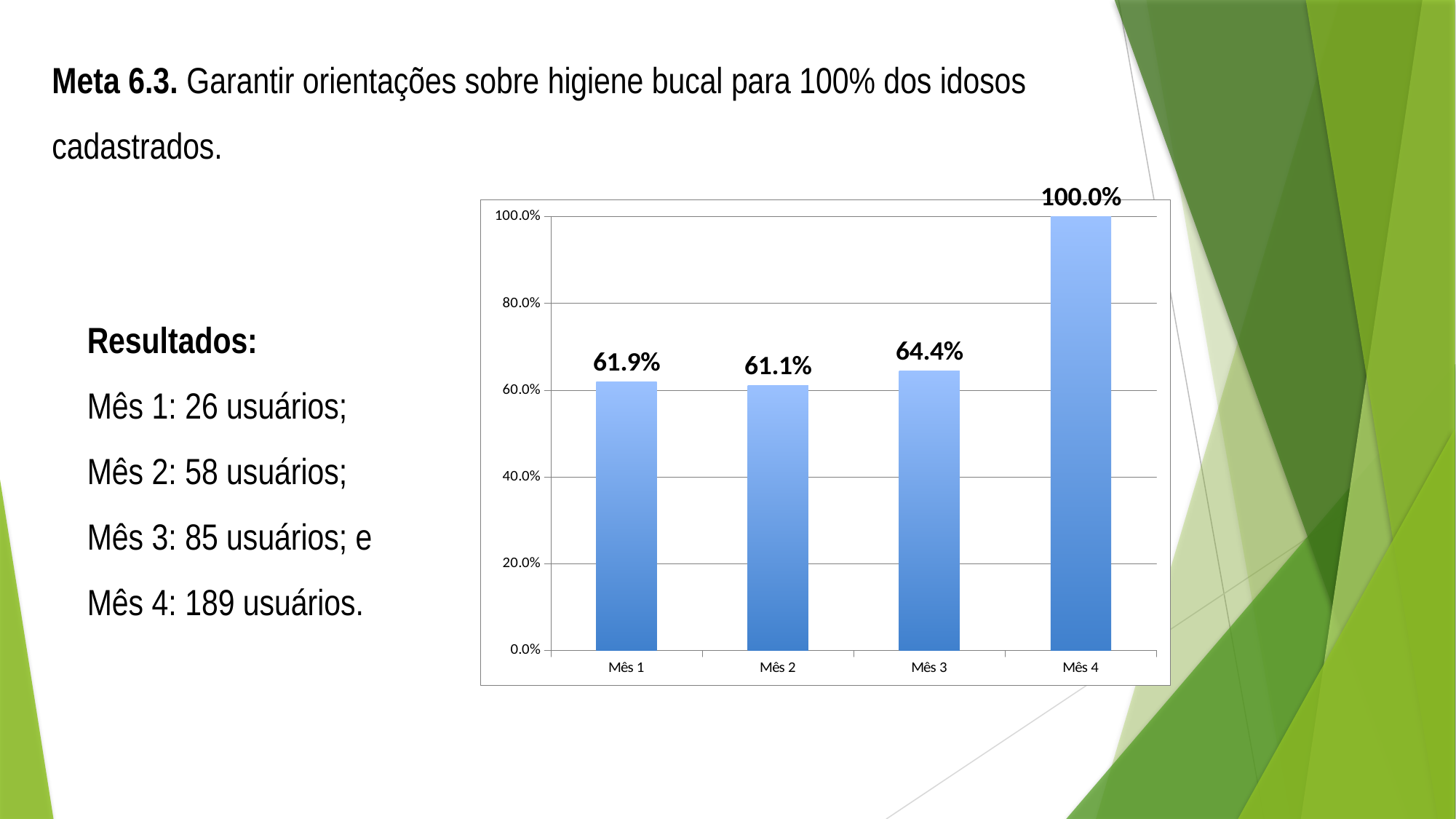
What is the value for Mês 4? 100.0% Which month has the lowest value? Mês 2 Which is larger, the value for Mês 3 or the value for Mês 1? Mês 3 How many months are shown on the x axis? 4 What is the value for Mês 2? 61.1% What is the difference between the values for Mês 1 and Mês 2? 0.8% Which month has the highest value? Mês 4 What is the value for Mês 1? 61.9% What kind of chart is shown on the slide? bar chart Is the value for Mês 2 greater or less than 80.0%? less What is the value for Mês 3? 64.4% What is the difference between the values for Mês 4 and Mês 3? 35.6%